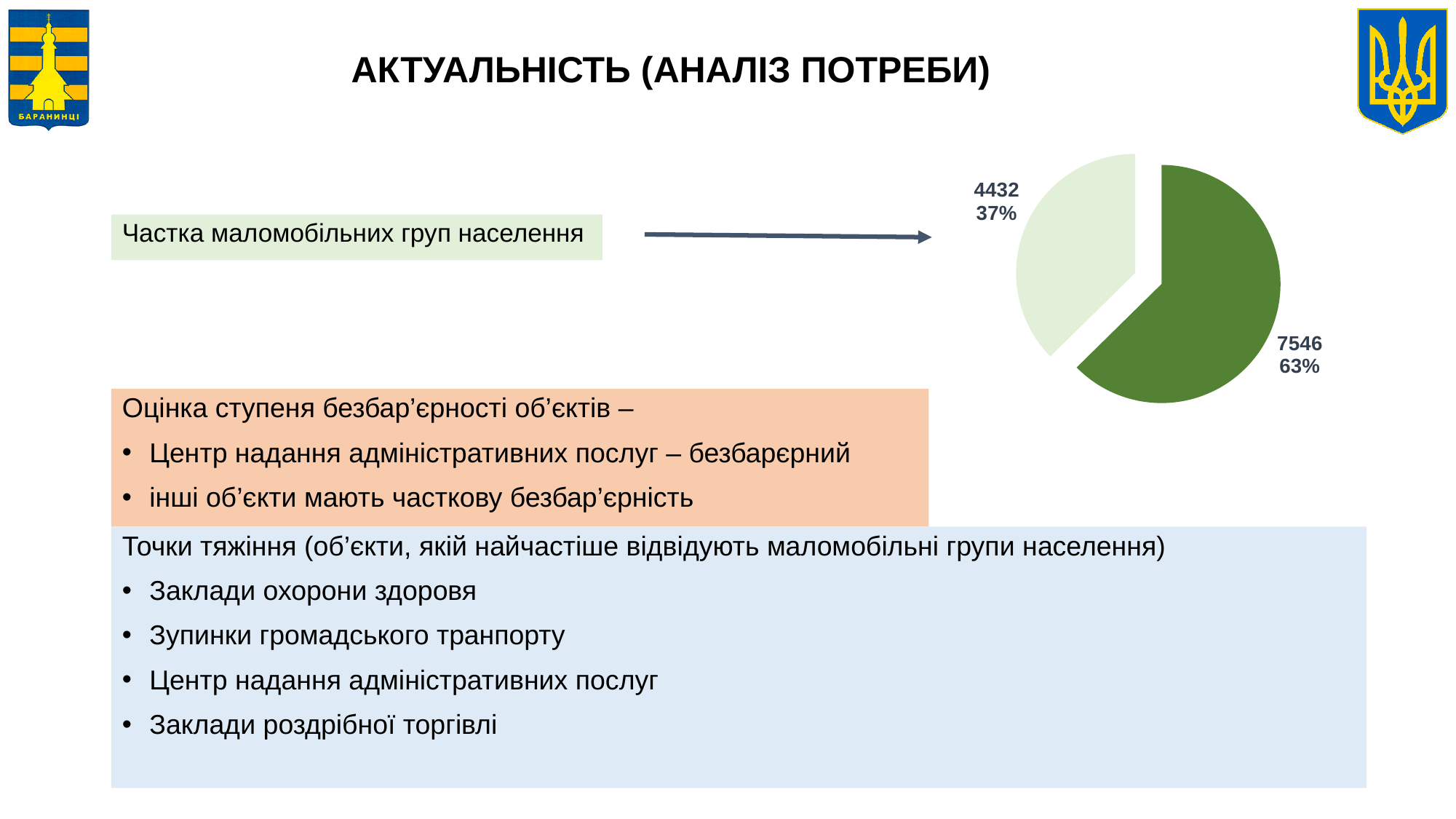
What percentage share does the dark green slice of the pie chart represent? 63% What is the largest value shown in the pie chart? 7546 Which slice of the pie chart is larger, the dark green one or the light green one? the dark green one What is the total of the two values shown in the pie chart? 11978 What is the smallest value shown in the pie chart? 4432 What value is labelled on the dark green slice of the pie chart? 7546 What is the difference between the two values shown in the pie chart (7546 and 4432)? 3114 What kind of chart is shown on the slide? pie chart What percentage share does the light green slice of the pie chart represent? 37% What value is labelled on the light green slice of the pie chart? 4432 How many slices does the pie chart have? 2 What text in the green box points to the pie chart? Частка маломобільних груп населення